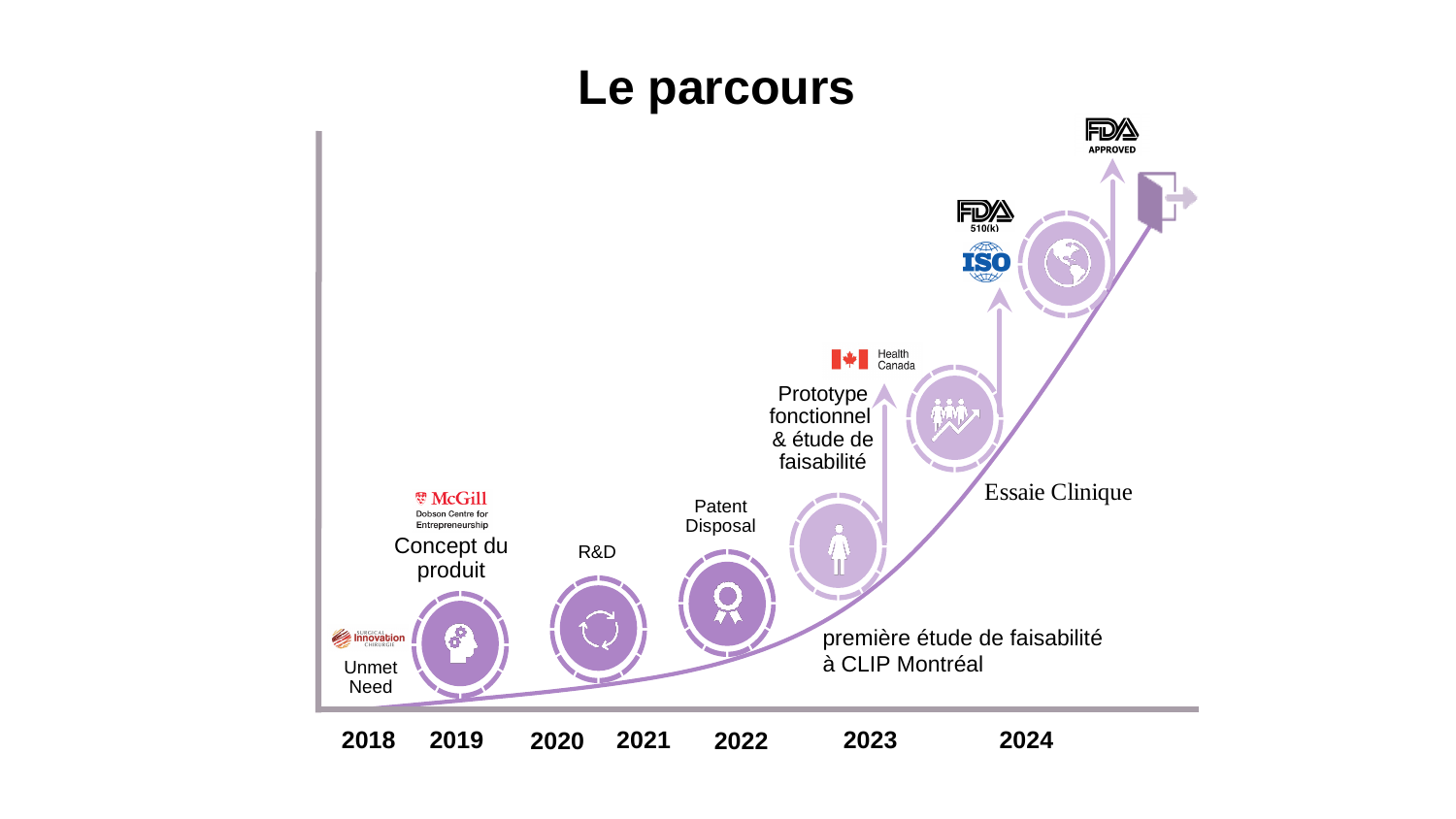
What is the first year shown on the x axis of the chart? 2018 What is the title of the chart on the slide? Le parcours What is the last year shown on the x axis of the chart? 2024 How many circular milestone icons are placed along the curve of the chart? 6 How many years are labelled along the x axis of the chart? 7 What label appears at the start of the curve, next to the year 2018? Unmet Need Does the curve on the chart rise or fall as the years increase along the x axis? rise